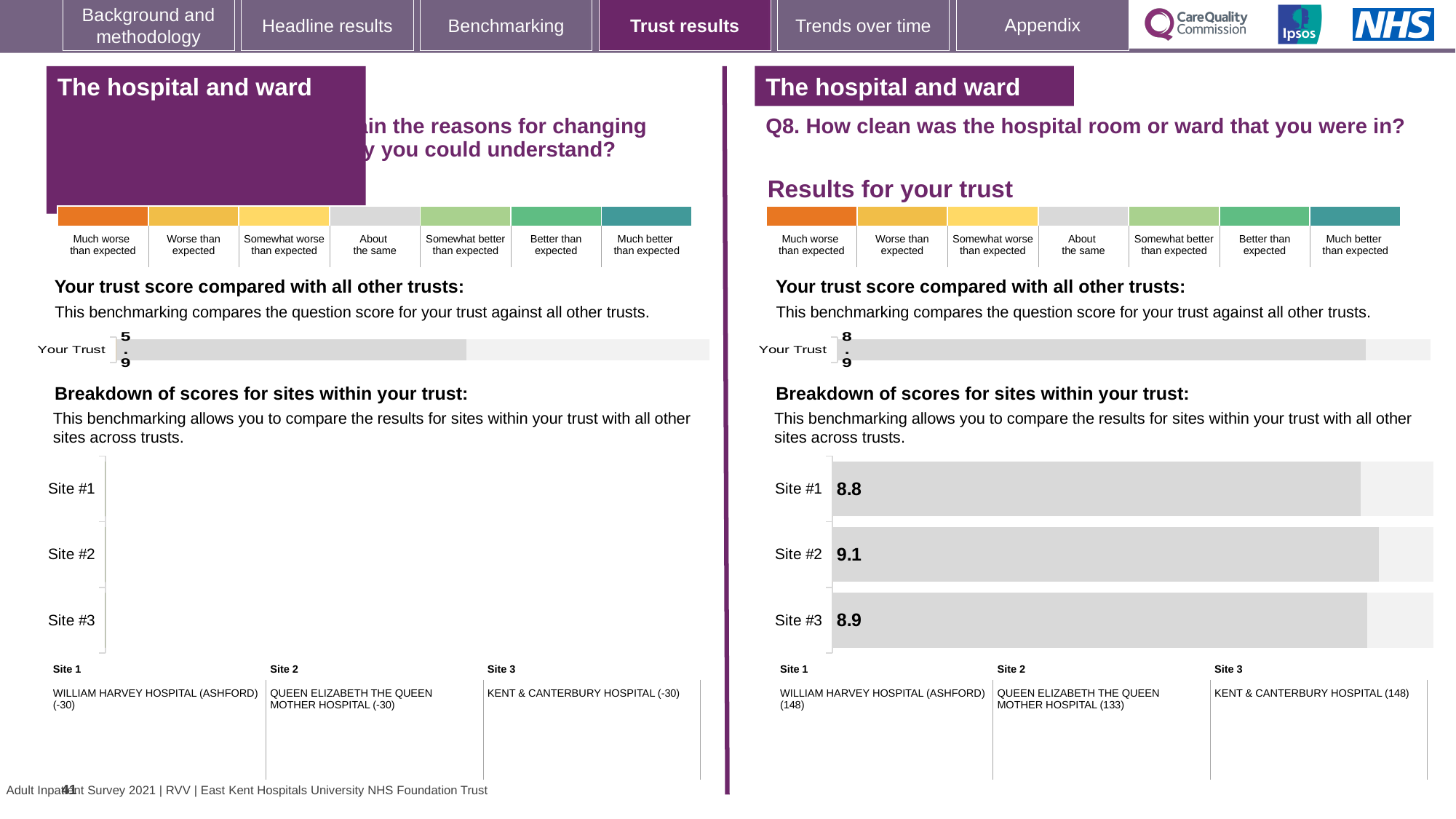
How many sites are shown in the Q8 site breakdown chart on the right-hand side? 3 In the 'Your trust score compared with all other trusts' chart on the right-hand side (Q8), what is the score for Your Trust? 8.9 In the Q8 site breakdown chart on the right-hand side, which has the higher score, Site #3 or Site #1? Site #3 In the 'Your trust score compared with all other trusts' chart on the left-hand side, what is the score for Your Trust? 5.9 In the Q8 site breakdown chart on the right-hand side, what is the score for Site #3? 8.9 In the Q8 site breakdown chart on the right-hand side, which site has the lowest score? Site #1 In the 'Breakdown of scores for sites within your trust' chart on the right-hand side (Q8), what is the score for Site #1? 8.8 In the Q8 site breakdown chart on the right-hand side, what is the difference between the scores for Site #2 and Site #3? 0.2 In the Q8 site breakdown chart on the right-hand side, what is the difference between the scores for Site #2 and Site #1? 0.3 In the Q8 site breakdown chart on the right-hand side, what is the score for Site #2? 9.1 In the Q8 site breakdown chart on the right-hand side, which site has the highest score? Site #2 What type of chart is the Q8 site breakdown chart on the right-hand side? Bar chart